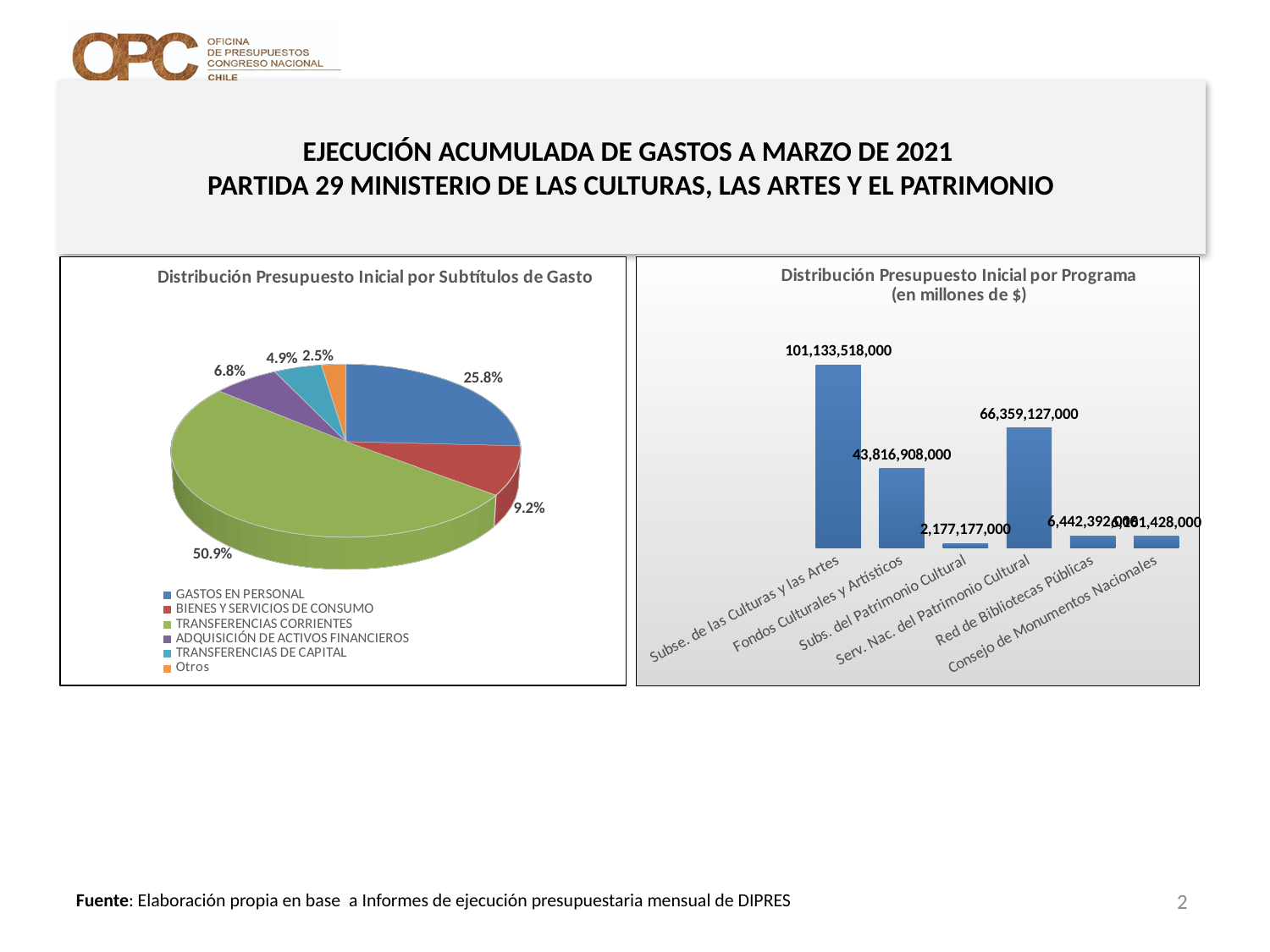
In the pie chart 'Distribución Presupuesto Inicial por Subtítulos de Gasto', how many percentage points larger is GASTOS EN PERSONAL than BIENES Y SERVICIOS DE CONSUMO? 16.6 percentage points In the chart 'Distribución Presupuesto Inicial por Programa', what is the value for Fondos Culturales y Artísticos? 43,816,908,000 In the chart 'Distribución Presupuesto Inicial por Programa', which is larger: Fondos Culturales y Artísticos or Serv. Nac. del Patrimonio Cultural? Serv. Nac. del Patrimonio Cultural In the chart 'Distribución Presupuesto Inicial por Programa', what is the value for Subse. de las Culturas y las Artes? 101,133,518,000 What kind of chart is 'Distribución Presupuesto Inicial por Programa'? Bar chart In the chart 'Distribución Presupuesto Inicial por Programa', which program has the lowest value? Subs. del Patrimonio Cultural In the pie chart 'Distribución Presupuesto Inicial por Subtítulos de Gasto', what share does GASTOS EN PERSONAL have? 25.8% In the pie chart 'Distribución Presupuesto Inicial por Subtítulos de Gasto', what share does TRANSFERENCIAS CORRIENTES have? 50.9% In the chart 'Distribución Presupuesto Inicial por Programa', what is the difference between Subse. de las Culturas y las Artes and Serv. Nac. del Patrimonio Cultural? 34,774,391,000 In the pie chart 'Distribución Presupuesto Inicial por Subtítulos de Gasto', which category has the smallest slice? Otros In the pie chart 'Distribución Presupuesto Inicial por Subtítulos de Gasto', which category has the largest slice? TRANSFERENCIAS CORRIENTES How many categories does the legend of the pie chart 'Distribución Presupuesto Inicial por Subtítulos de Gasto' list? 6